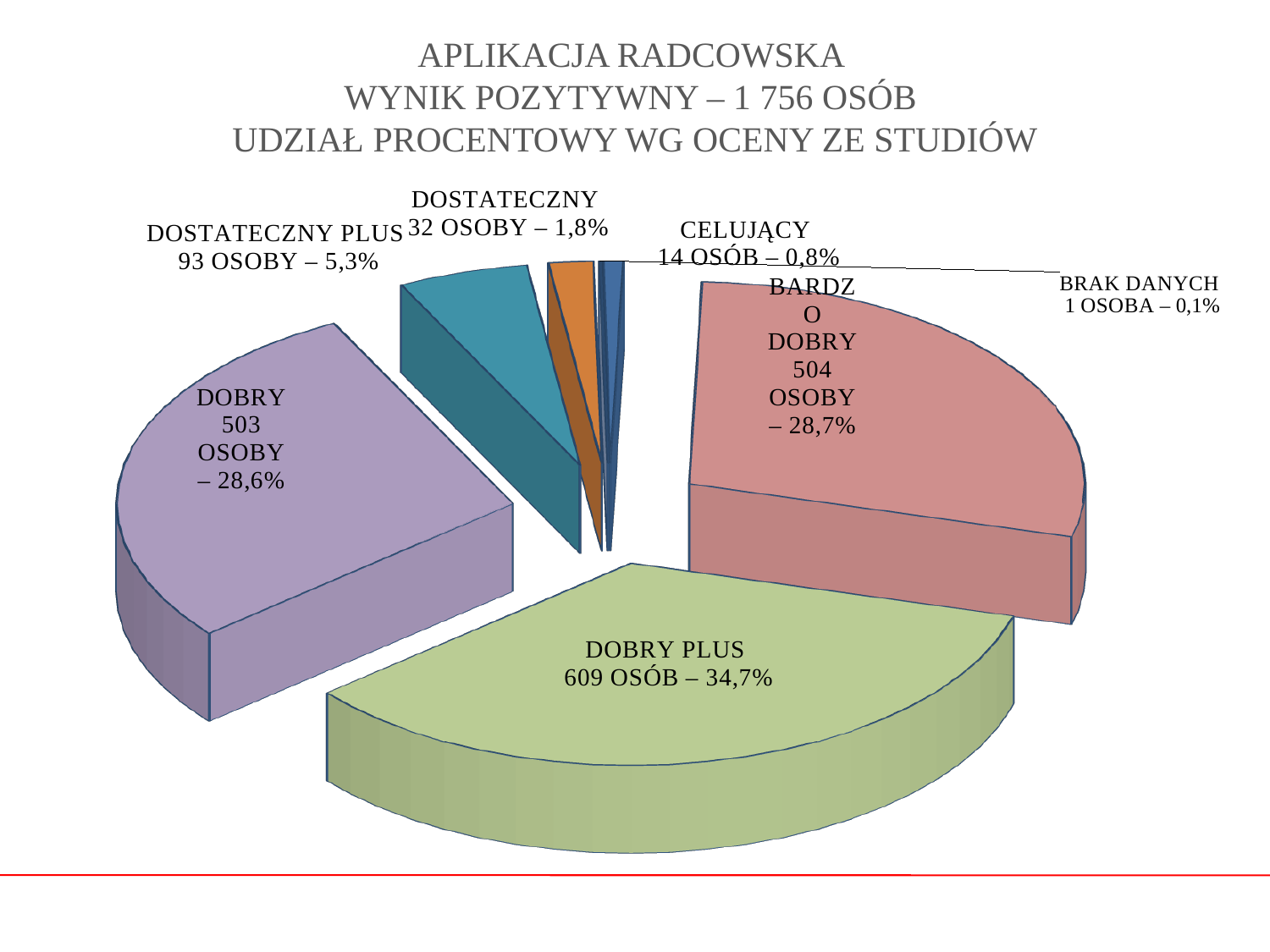
What percentage is shown for the DOSTATECZNY PLUS slice? 5,3% How many people are in the CELUJĄCY category? 14 Which category has the smallest share of the pie? BRAK DANYCH Which has more people, BARDZO DOBRY or DOBRY? BARDZO DOBRY What percentage share does the DOBRY PLUS slice have? 34,7% How many slices does the pie chart have? 7 Which category has the largest share of the pie? DOBRY PLUS According to the chart title, how many people had a positive result (WYNIK POZYTYWNY)? 1 756 OSÓB What is the difference in number of people between DOBRY PLUS and BARDZO DOBRY? 105 How many people are in the BARDZO DOBRY category? 504 What kind of chart is shown on the slide? pie chart What percentage is shown for the DOSTATECZNY slice? 1,8%